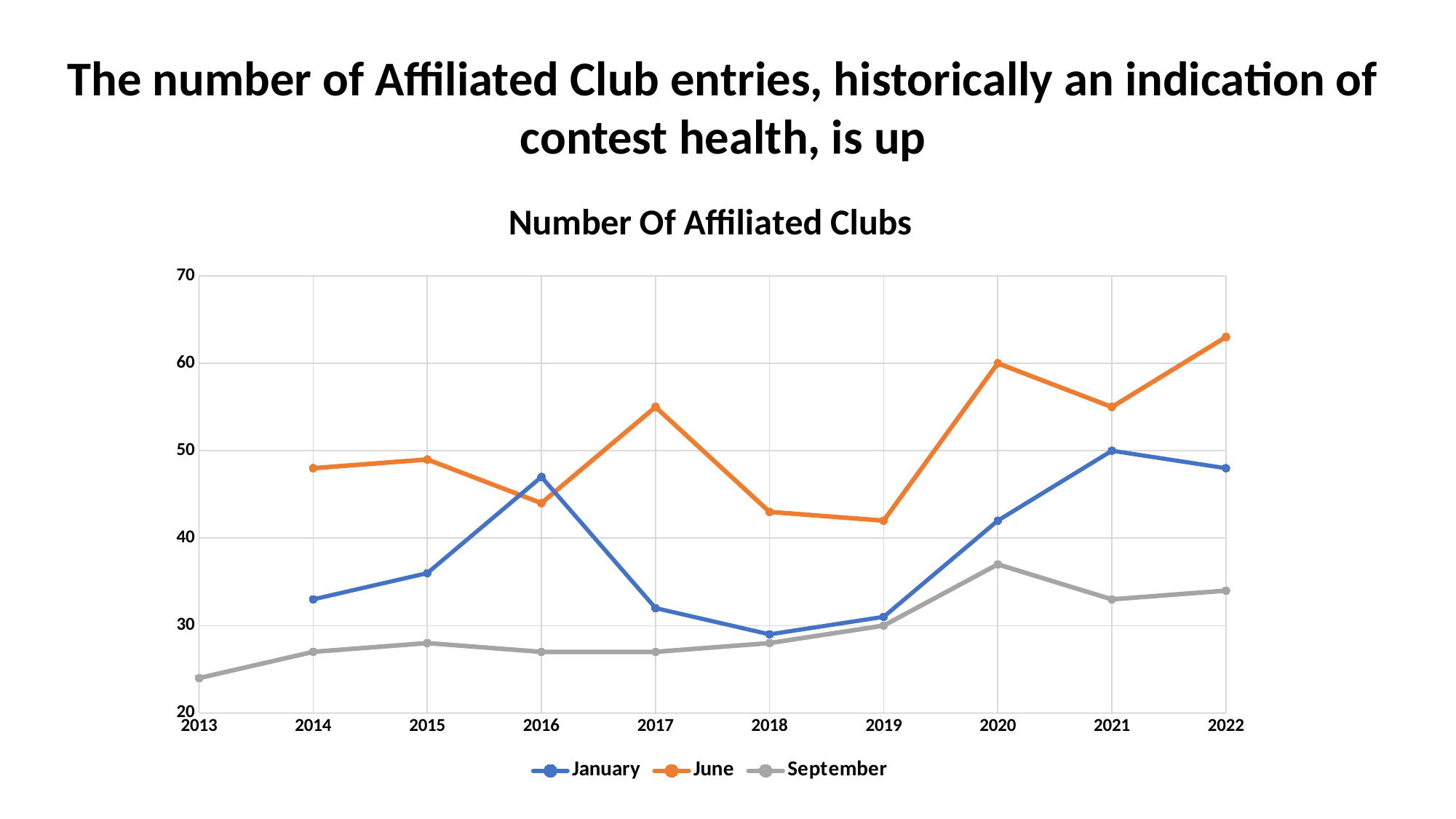
In which year is the June series at its highest? 2022 Does the June series rise or fall from 2019 to 2020? rise How many series does the legend list? 3 Which series is drawn in orange? June How many years are shown on the x axis? 10 What is the title of the chart? Number Of Affiliated Clubs Is the value for September in 2020 greater or less than 40? less In which year is the September series at its lowest? 2013 What kind of chart is shown on the slide? line chart In 2016, which is larger, the January value or the June value? January Is the value for June in 2022 greater or less than 60? greater In which year is the January series at its highest? 2021